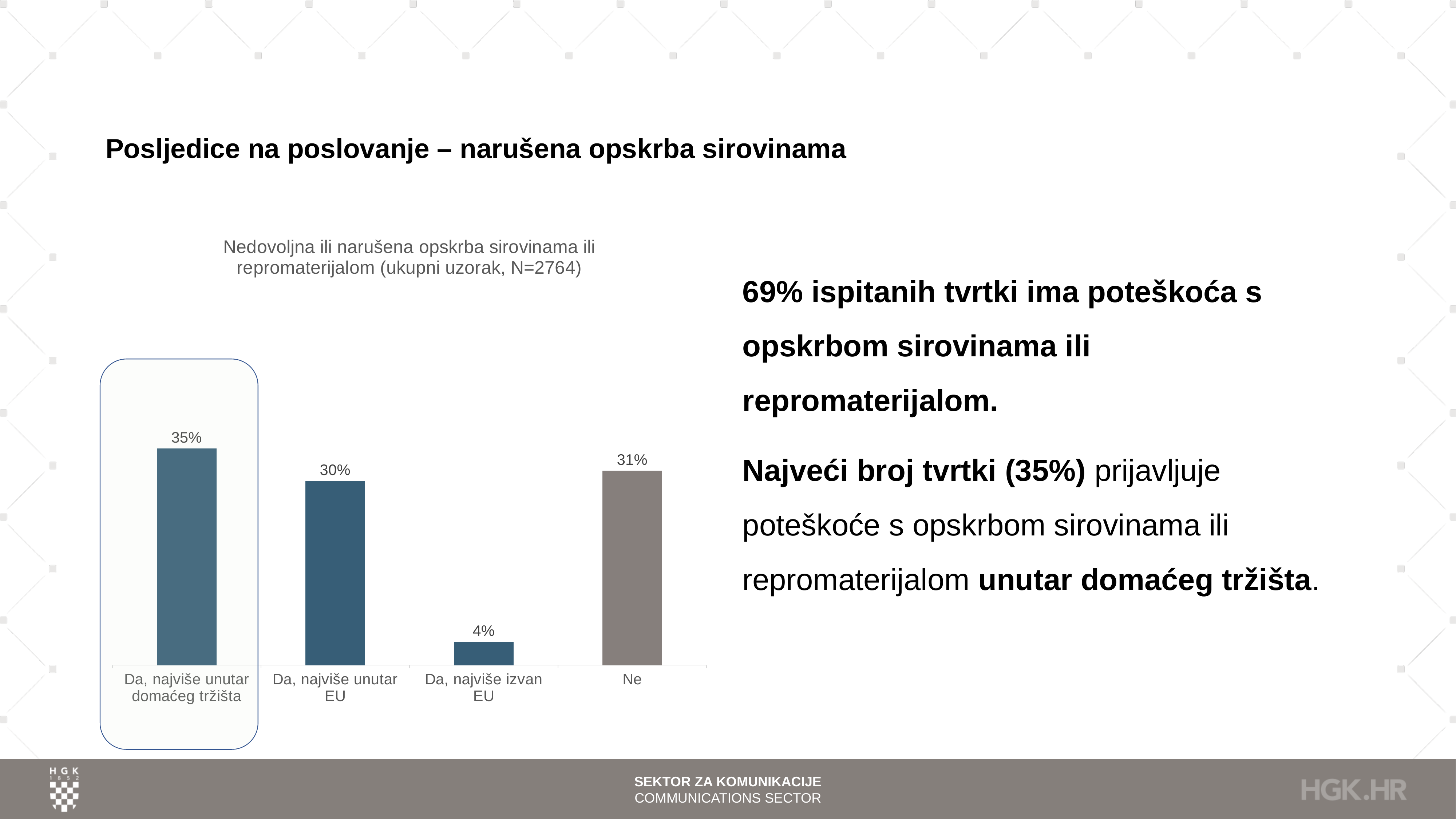
How many categories are shown in the chart? 4 What is the value for "Da, najviše izvan EU"? 4% What is the difference between the values for "Da, najviše unutar domaćeg tržišta" and "Da, najviše unutar EU"? 5% What kind of chart is shown on the slide? Bar chart Which category has the lowest value? Da, najviše izvan EU Which is larger, the value for "Ne" or the value for "Da, najviše izvan EU"? Ne Which category has the highest value? Da, najviše unutar domaćeg tržišta What is the value for "Da, najviše unutar EU"? 30% What is the difference between the values for "Ne" and "Da, najviše izvan EU"? 27% What is the value for "Ne"? 31% What is the value for "Da, najviše unutar domaćeg tržišta"? 35% What sample size (N) is stated in the chart title? N=2764